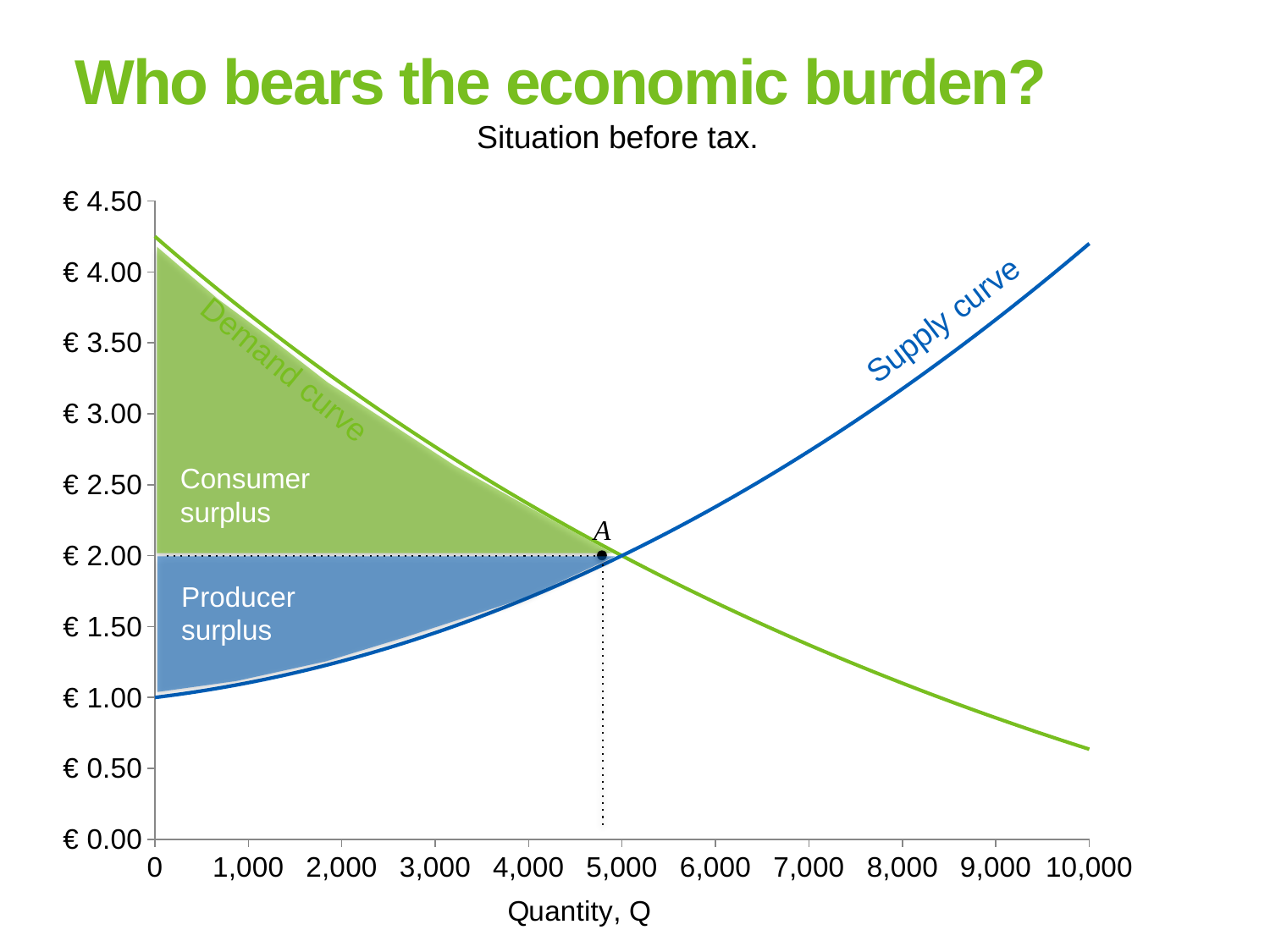
What kind of chart is shown on the slide? Line chart How many curves are plotted on the chart? 2 Is the price on the demand curve at a quantity of 0 greater or less than € 4.00? greater What is the label of the x axis? Quantity, Q What is the price on the supply curve at a quantity of 0? € 1.00 Is the quantity at point A greater or less than 4,000? greater Is the price on the demand curve at a quantity of 10,000 greater or less than € 1.00? less Does the demand curve rise or fall as quantity increases? Fall Does the supply curve rise or fall as quantity increases? Rise What is the price at point A? € 2.00 At a quantity of 2,000, which curve shows the higher price, the demand curve or the supply curve? Demand curve What is the subtitle shown above the chart? Situation before tax.